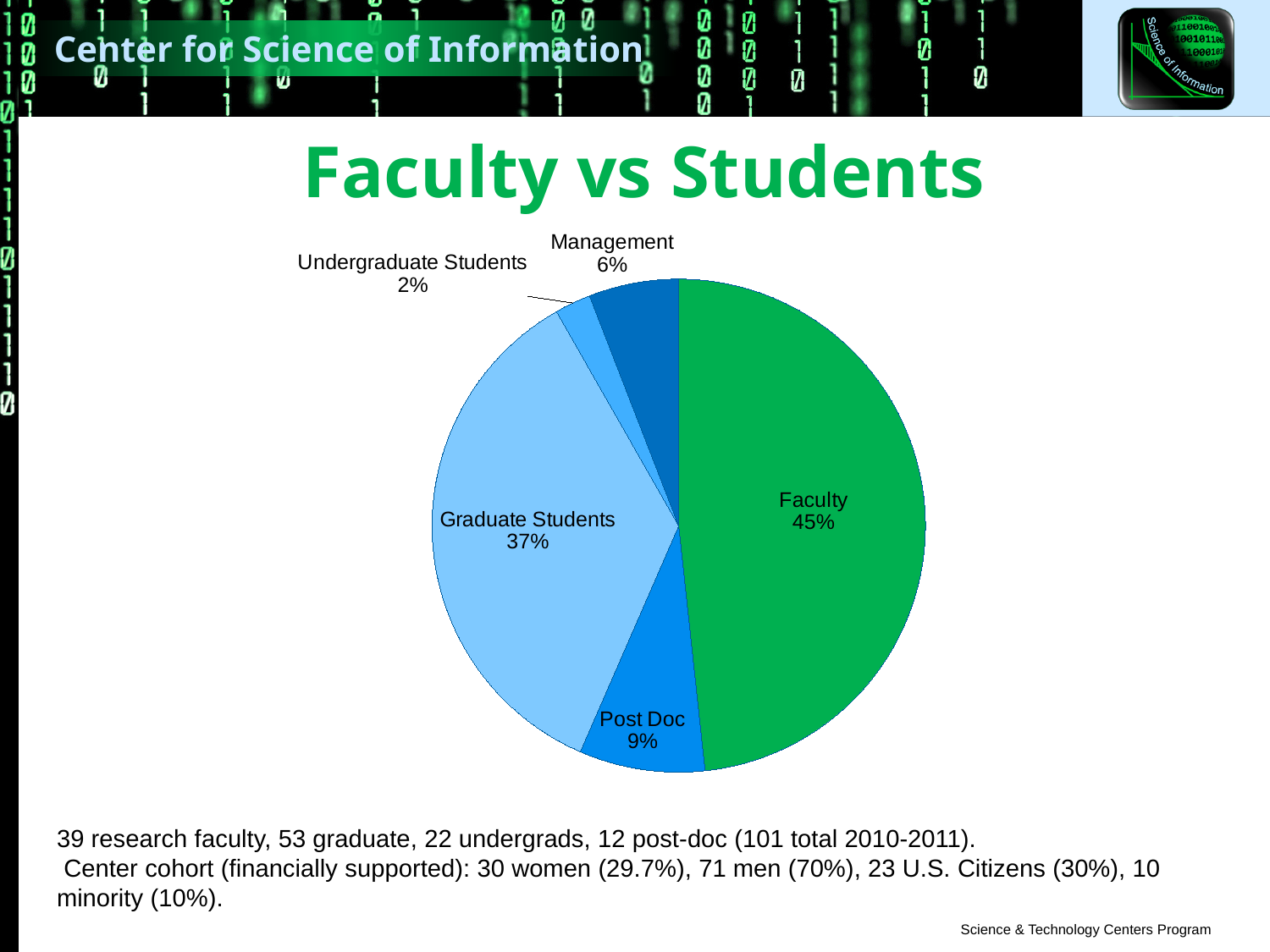
What share of the pie does Faculty represent? 45% Which category has the largest slice of the pie? Faculty What is the value shown for Undergraduate Students? 2% What is the title of the chart? Faculty vs Students What type of chart is shown on the slide? pie chart What is the value shown for Post Doc? 9% How many categories are shown in the pie chart? 5 Which category has the smallest slice of the pie? Undergraduate Students What is the difference in percentage points between Faculty and Graduate Students? 8 What is the value shown for Management? 6% What share of the pie does Graduate Students represent? 37% Which is larger, the Post Doc slice or the Management slice? Post Doc